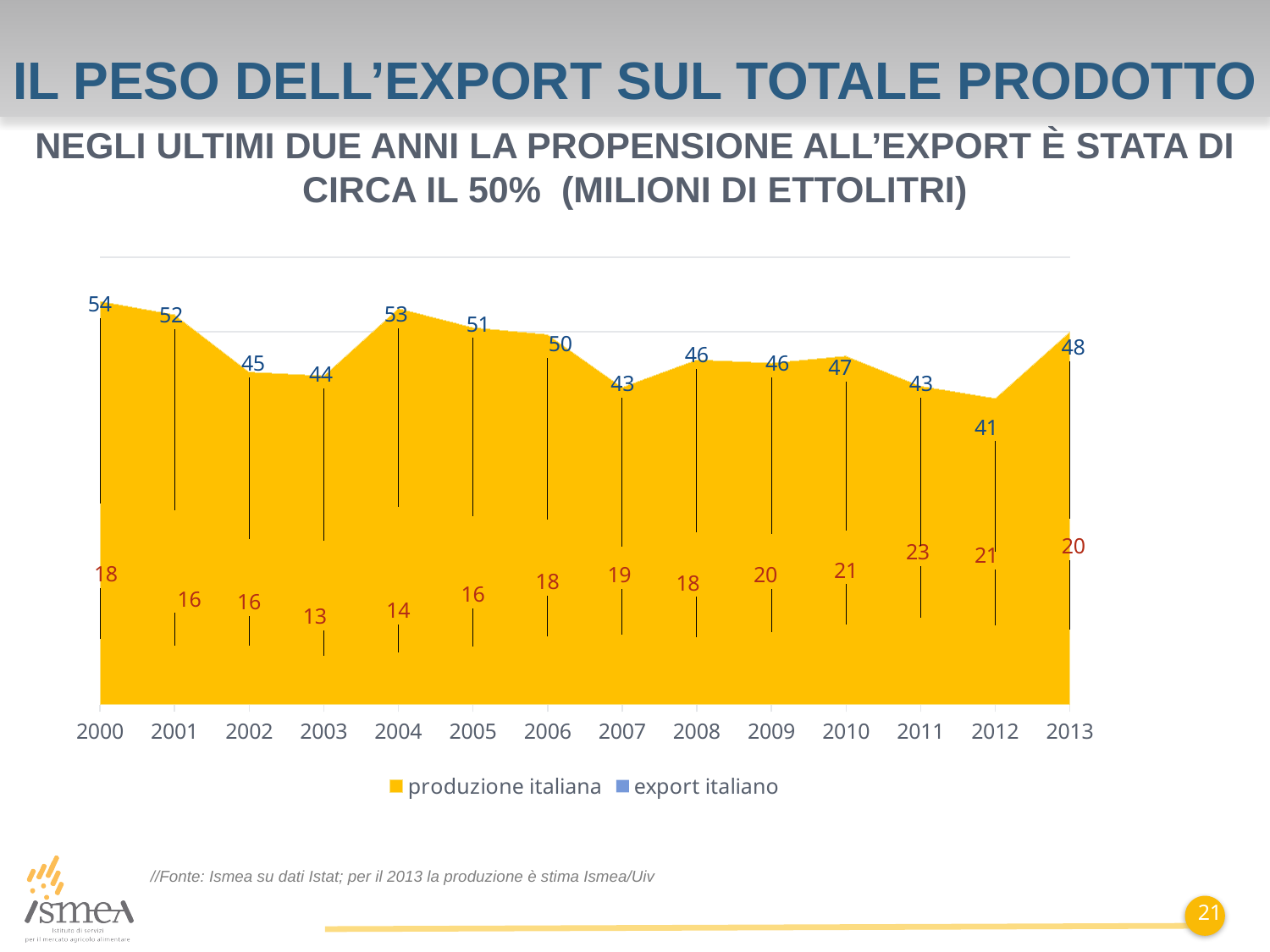
In which year is produzione italiana lowest? 2012 What is the value of export italiano in 2003? 13 How many years are shown on the x axis? 14 In which year is produzione italiana highest? 2000 In which year is export italiano lowest? 2003 How many series does the legend list? 2 What is the difference between produzione italiana and export italiano in 2013? 28 Which is larger, produzione italiana in 2004 or in 2005? 2004 What kind of chart is shown on the slide? area chart What is the value of export italiano in 2011? 23 What is the value of produzione italiana in 2012? 41 What is the value of produzione italiana in 2000? 54